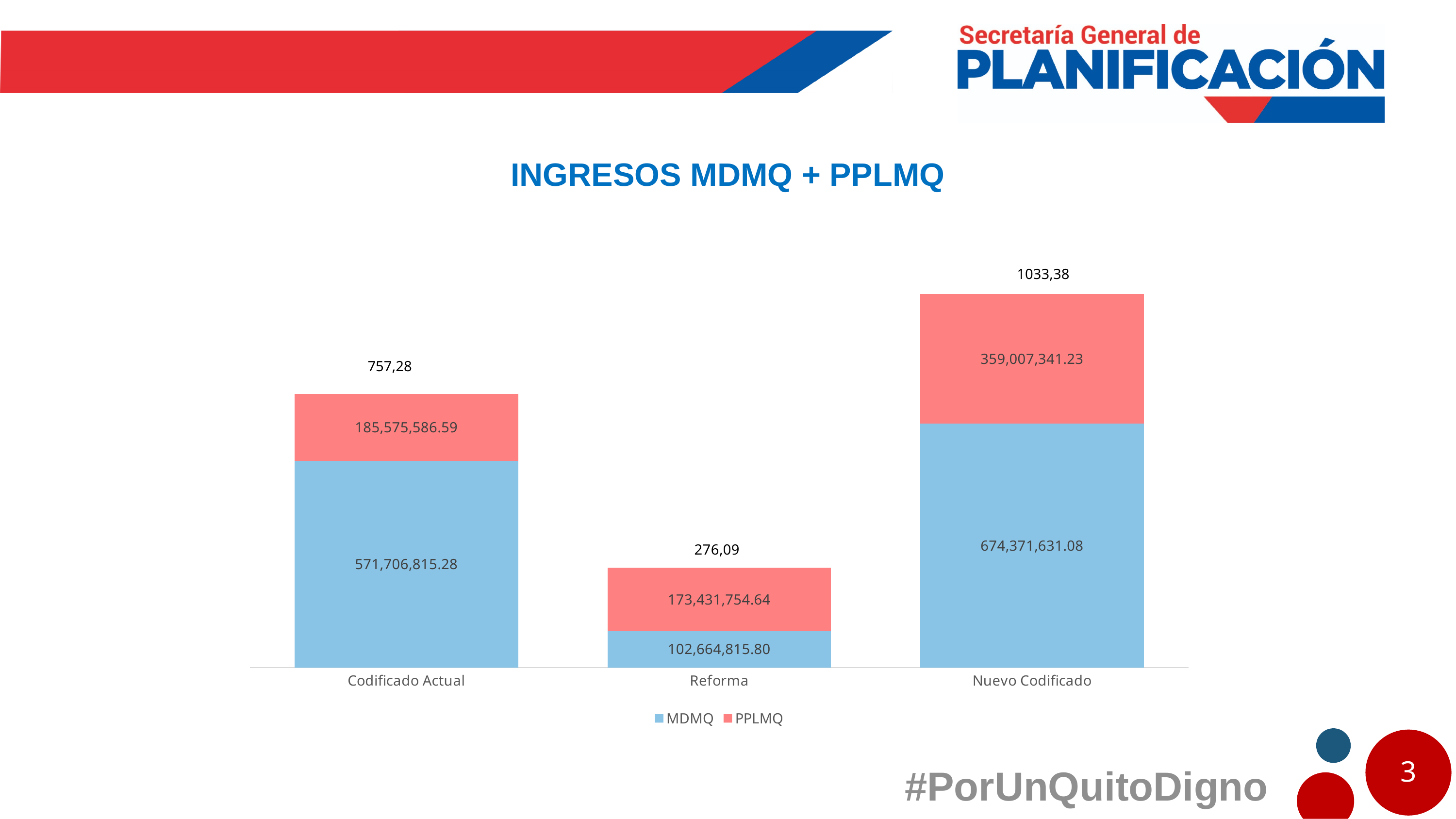
What is the MDMQ value for Codificado Actual? 571,706,815.28 Which category has the highest MDMQ value? Nuevo Codificado What total is printed above the Reforma bar? 276,09 How many series does the legend list? 2 What is the MDMQ value for Nuevo Codificado? 674,371,631.08 What is the PPLMQ value for Reforma? 173,431,754.64 In the Reforma bar, which is larger: MDMQ or PPLMQ? PPLMQ What is the PPLMQ value for Nuevo Codificado? 359,007,341.23 What is the difference between the PPLMQ value for Nuevo Codificado and the PPLMQ value for Codificado Actual? 173,431,754.64 Which category has the lowest total? Reforma What total is printed above the Nuevo Codificado bar? 1033,38 How many categories are shown on the x axis? 3